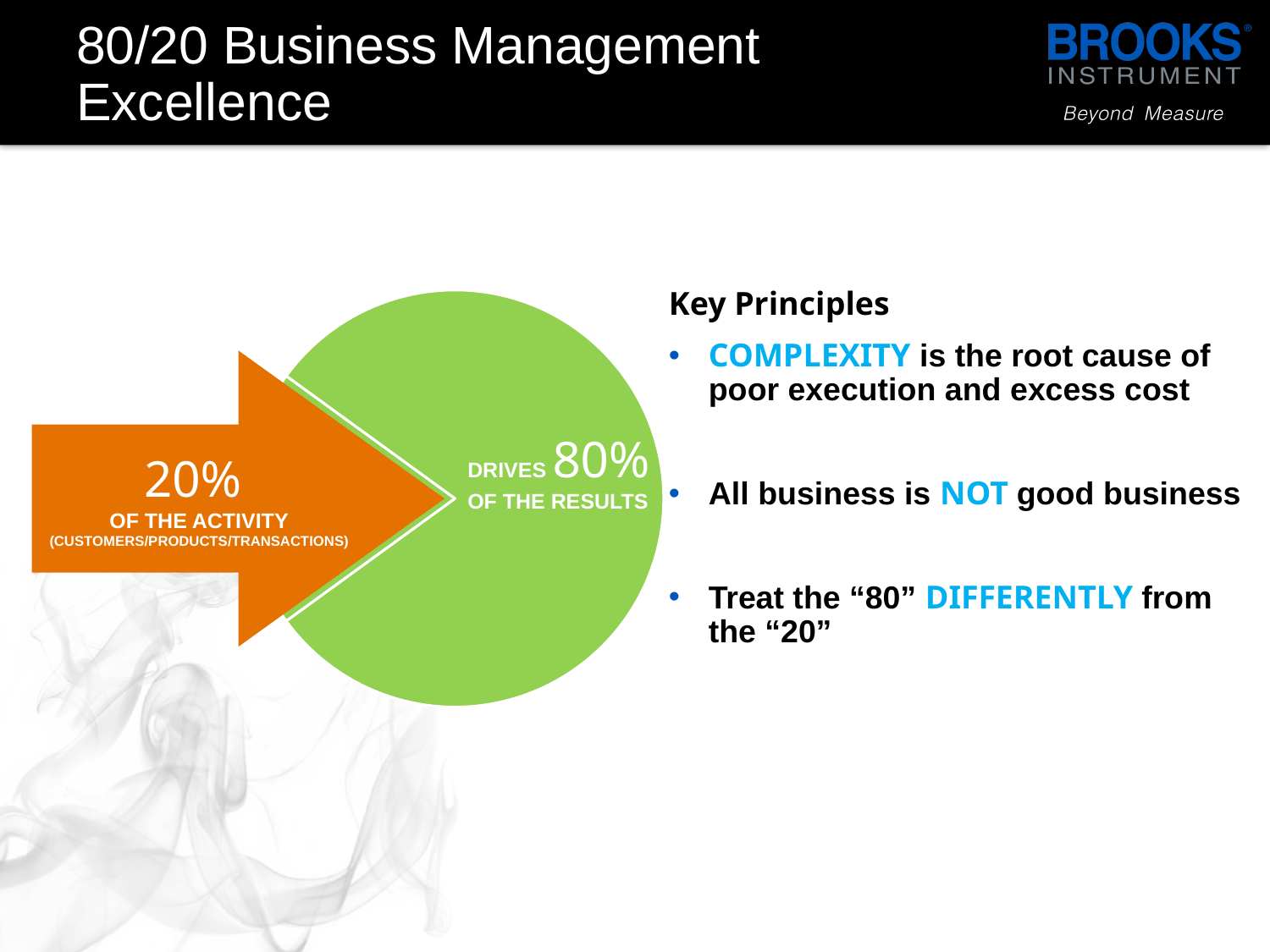
In the 80/20 graphic, what percentage of the results is shown in the green circle? 80% In the 80/20 graphic, what percentage of the activity is shown in the orange arrow? 20% In the 80/20 graphic, what is the difference between the percentage of the results and the percentage of the activity? 60% In the 80/20 graphic, what colour is the shape labelled '80% OF THE RESULTS'? green In the 80/20 graphic, which is larger: the percentage of the activity or the percentage of the results? the percentage of the results In the 80/20 graphic, what examples of activity are listed under '20% OF THE ACTIVITY'? Customers/Products/Transactions